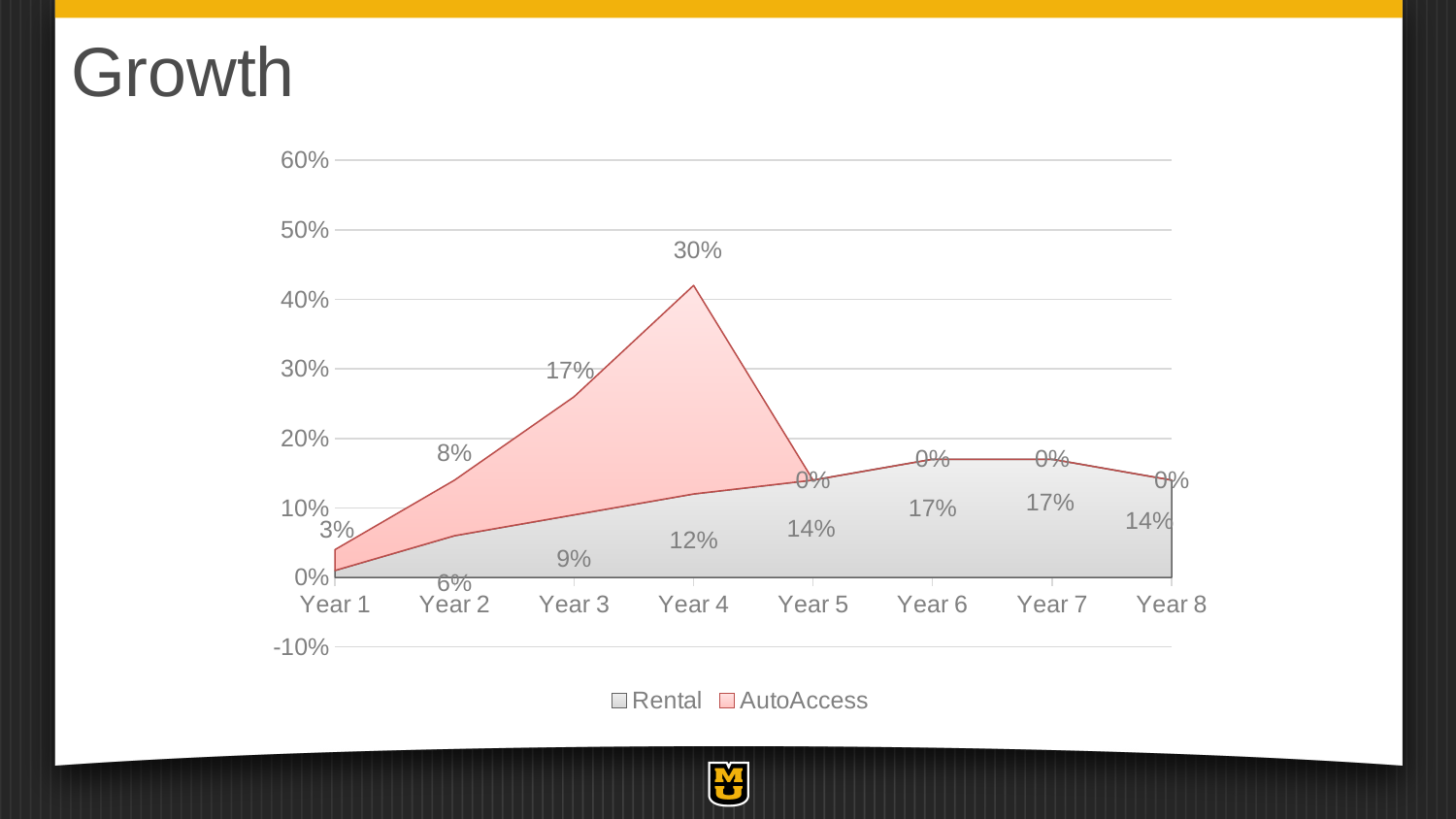
What is the AutoAccess value for Year 2? 8% How many years are shown on the x axis? 8 How many series does the legend list? 2 In which year is the AutoAccess value highest? Year 4 What is the Rental value for Year 3? 9% What is the AutoAccess value for Year 4? 30% Does the AutoAccess value rise or fall from Year 1 to Year 4? Rise What is the combined total of Rental and AutoAccess for Year 4? 42% What is the difference between the AutoAccess values for Year 4 and Year 3? 13% What is the Rental value for Year 6? 17% Which is larger, the Rental value for Year 4 or for Year 6? Year 6 What kind of chart is shown on the slide? Area chart